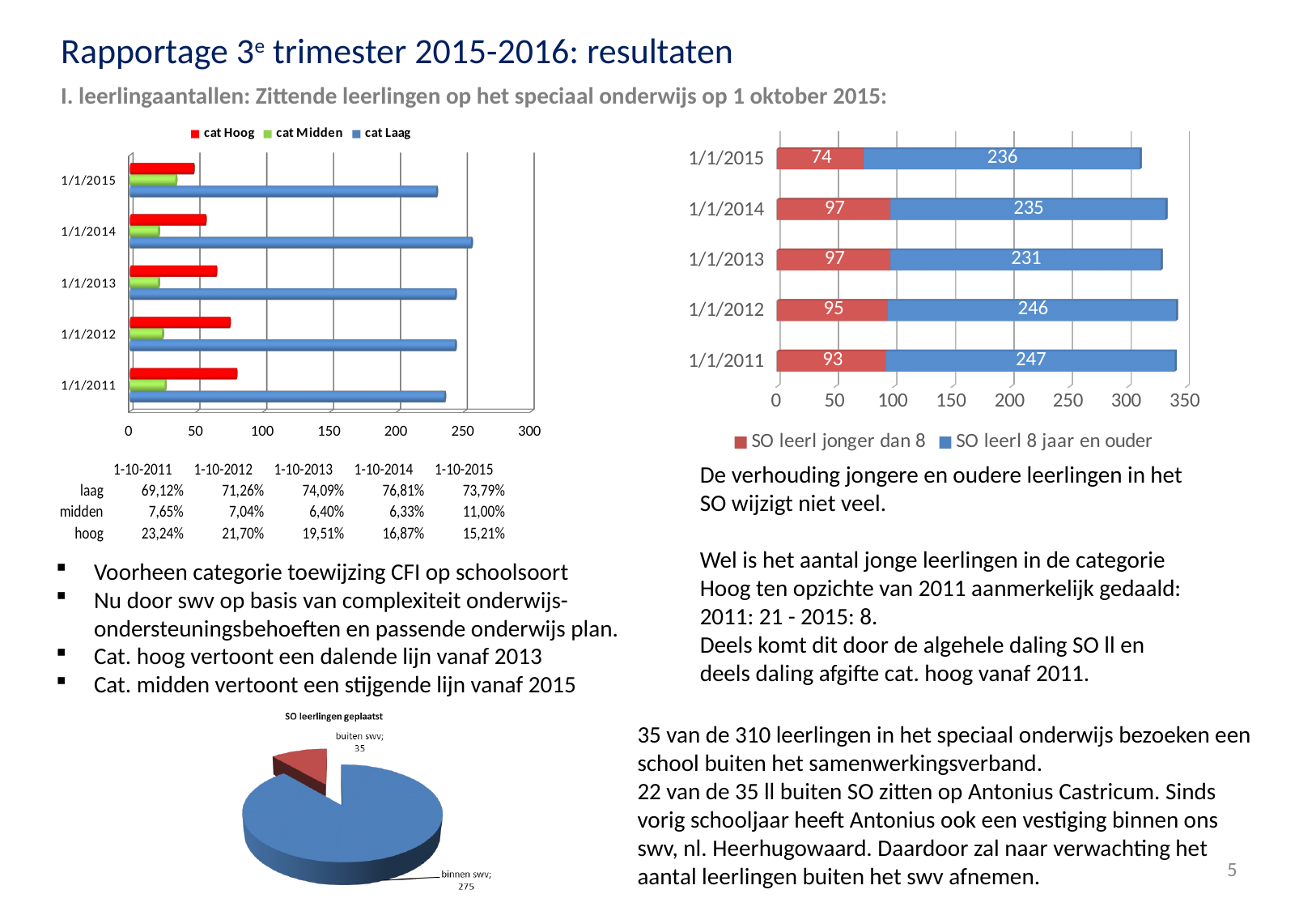
In the top-right stacked bar chart, what is the total of the stacked bar for 1/1/2011? 340 In the top-left bar chart, is the value for 'cat Laag' on 1/1/2014 greater or less than 200? greater In the top-right stacked bar chart, what is the difference between the 'SO leerl jonger dan 8' values for 1/1/2014 and 1/1/2015? 23 In the top-right stacked bar chart, what is the value for 'SO leerl jonger dan 8' on 1/1/2015? 74 How many series does the legend of the top-left bar chart list? 3 In the top-right stacked bar chart, which year has the lowest value for 'SO leerl jonger dan 8'? 1/1/2015 In the top-left bar chart, is the value for 'cat Midden' on 1/1/2015 greater or less than 50? less How many series does the legend of the top-right stacked bar chart list? 2 In the pie chart 'SO leerlingen geplaatst', what is the value for 'buiten swv'? 35 In the top-right stacked bar chart, which year has the highest value for 'SO leerl 8 jaar en ouder'? 1/1/2011 In the top-right stacked bar chart, what is the value for 'SO leerl 8 jaar en ouder' on 1/1/2012? 246 What kind of chart is the chart titled 'SO leerlingen geplaatst' at the bottom of the slide? pie chart